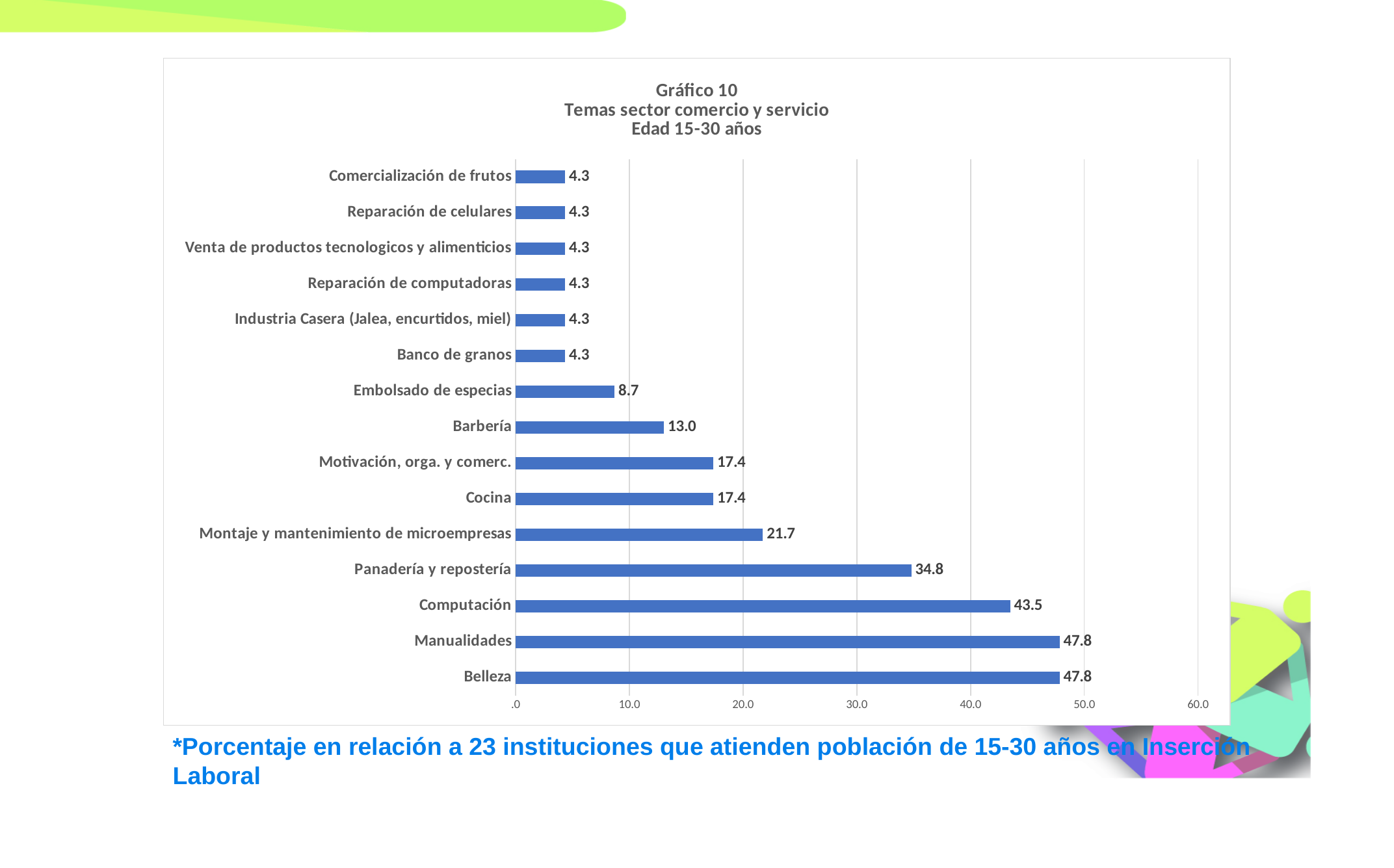
What is the value for Montaje y mantenimiento de microempresas? 21.7 What is the difference between the values for Computación and Panadería y repostería? 8.7 What is the value for Panadería y repostería? 34.8 What is the value for Computación? 43.5 What is the lowest value shown in the chart? 4.3 What is the value for Barbería? 13.0 What kind of chart is shown on the slide? bar chart What is the title of the chart? Gráfico 10 Temas sector comercio y servicio Edad 15-30 años What is the highest value shown in the chart? 47.8 How many categories are shown in the chart? 15 What is the value for Embolsado de especias? 8.7 Which has a larger value, Cocina or Barbería? Cocina